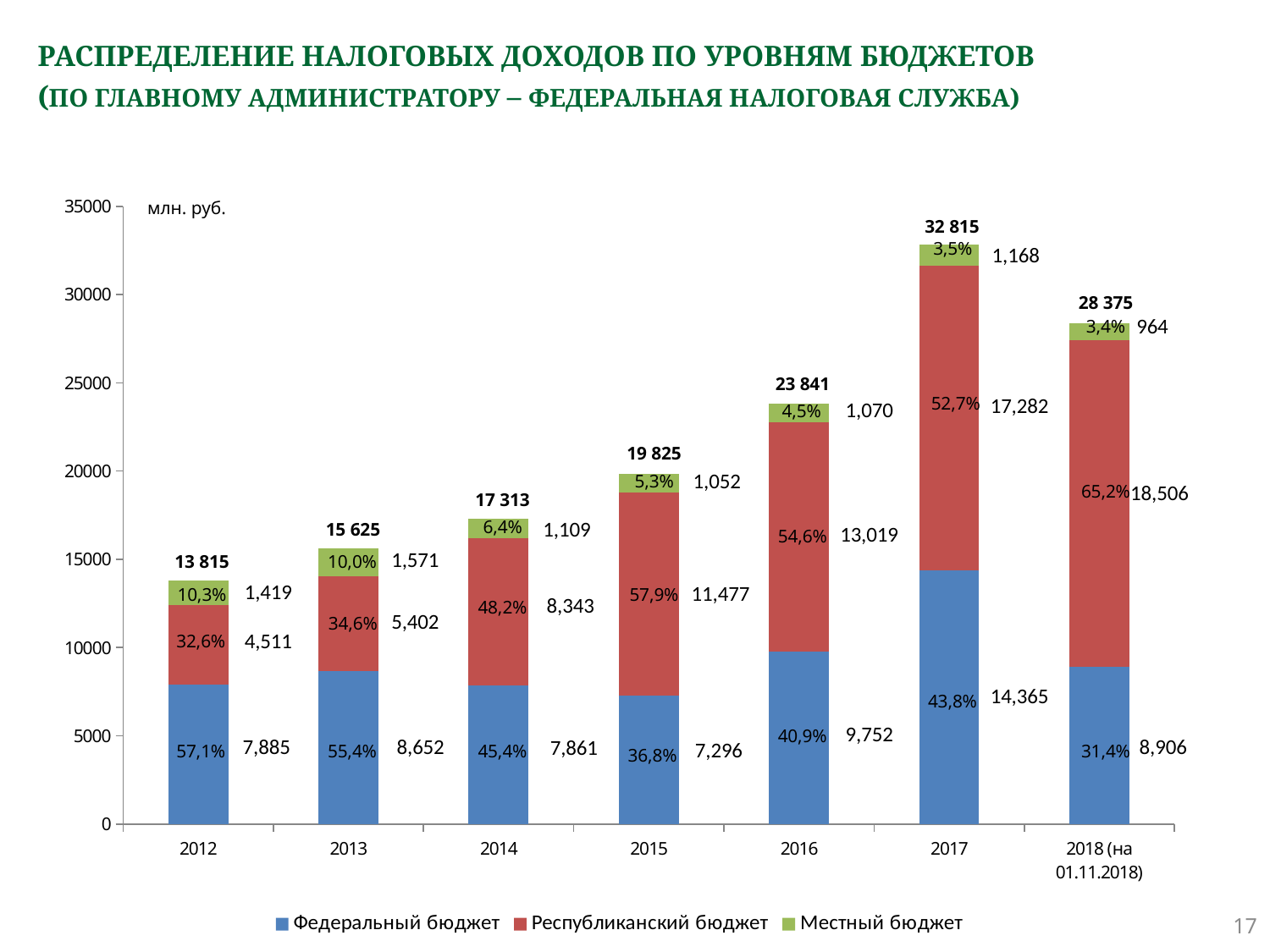
Which is larger: Республиканский бюджет in 2017 or in 2018 (на 01.11.2018)? 2018 (на 01.11.2018) Which year has the lowest total bar? 2012 Which year has the highest total bar? 2017 What is the total value printed above the bar for 2017? 32 815 Do the total values rise or fall from 2012 to 2017? rise What is the value of Федеральный бюджет for 2016? 9,752 How many years (categories) are shown on the x axis? 7 What is the difference between the total for 2017 and the total for 2018 (на 01.11.2018)? 4 440 How many series does the legend list? 3 What is the value of Местный бюджет for 2018 (на 01.11.2018)? 964 What percentage share is printed for Местный бюджет in 2013? 10,0% What kind of chart is shown on the slide? bar chart